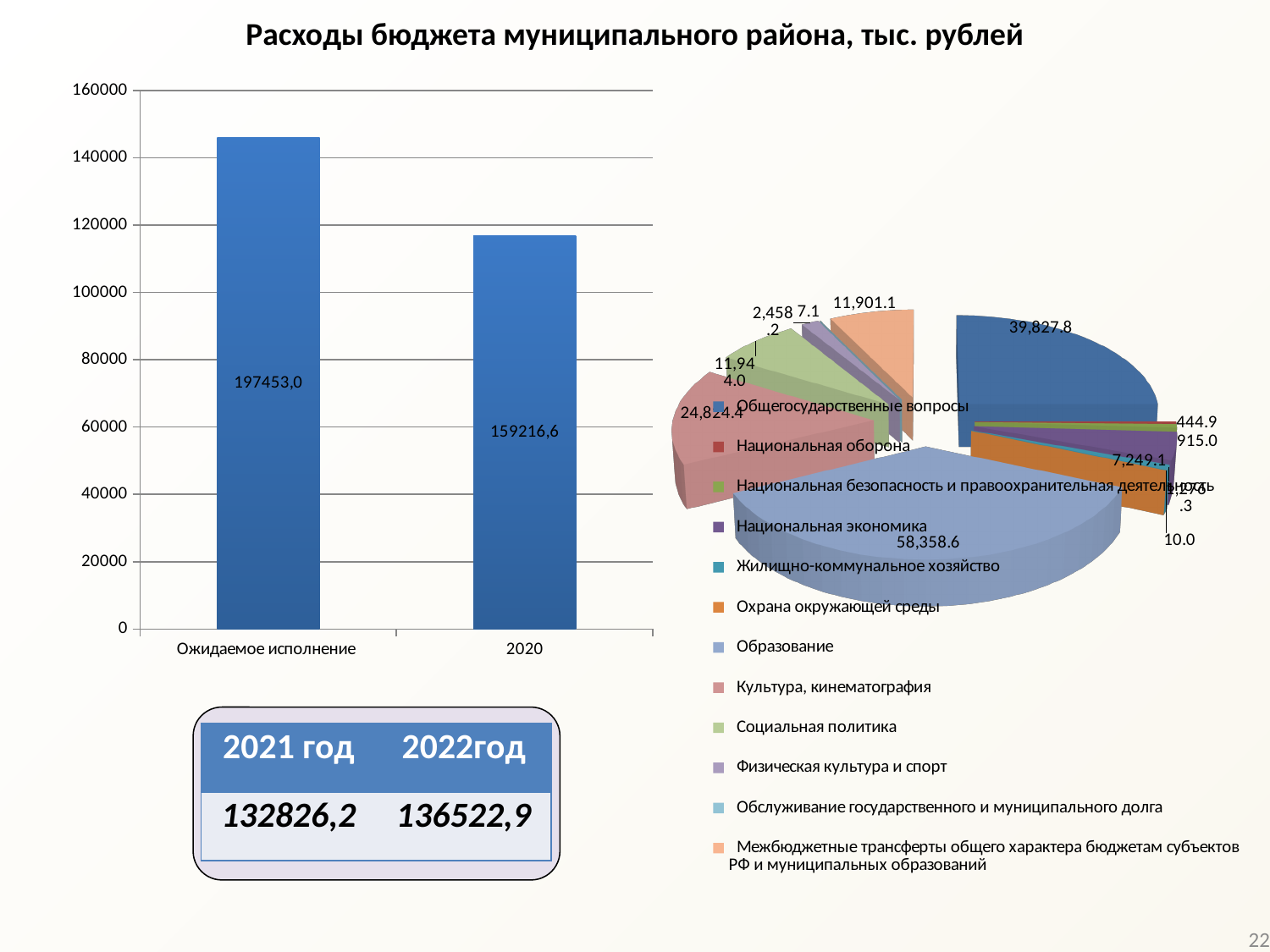
In the bar chart on the left, which category has the higher value, 'Ожидаемое исполнение' or '2020'? Ожидаемое исполнение What kind of chart is on the right side of the slide? pie chart How many entries does the legend of the pie chart on the right list? 12 In the pie chart on the right, what is the value for 'Образование'? 58,358.6 In the pie chart on the right, what is the value for 'Общегосударственные вопросы'? 39,827.8 What kind of chart is on the left side of the slide? bar chart In the pie chart on the right, which category has the largest slice? Образование In the bar chart on the left, what is the value for '2020'? 159216,6 In the bar chart on the left, what is the difference between the values for 'Ожидаемое исполнение' and '2020'? 38236,4 How many bars are in the bar chart on the left? 2 In the pie chart on the right, what is the value for 'Культура, кинематография'? 24,824.4 In the bar chart on the left, what is the value for 'Ожидаемое исполнение'? 197453,0